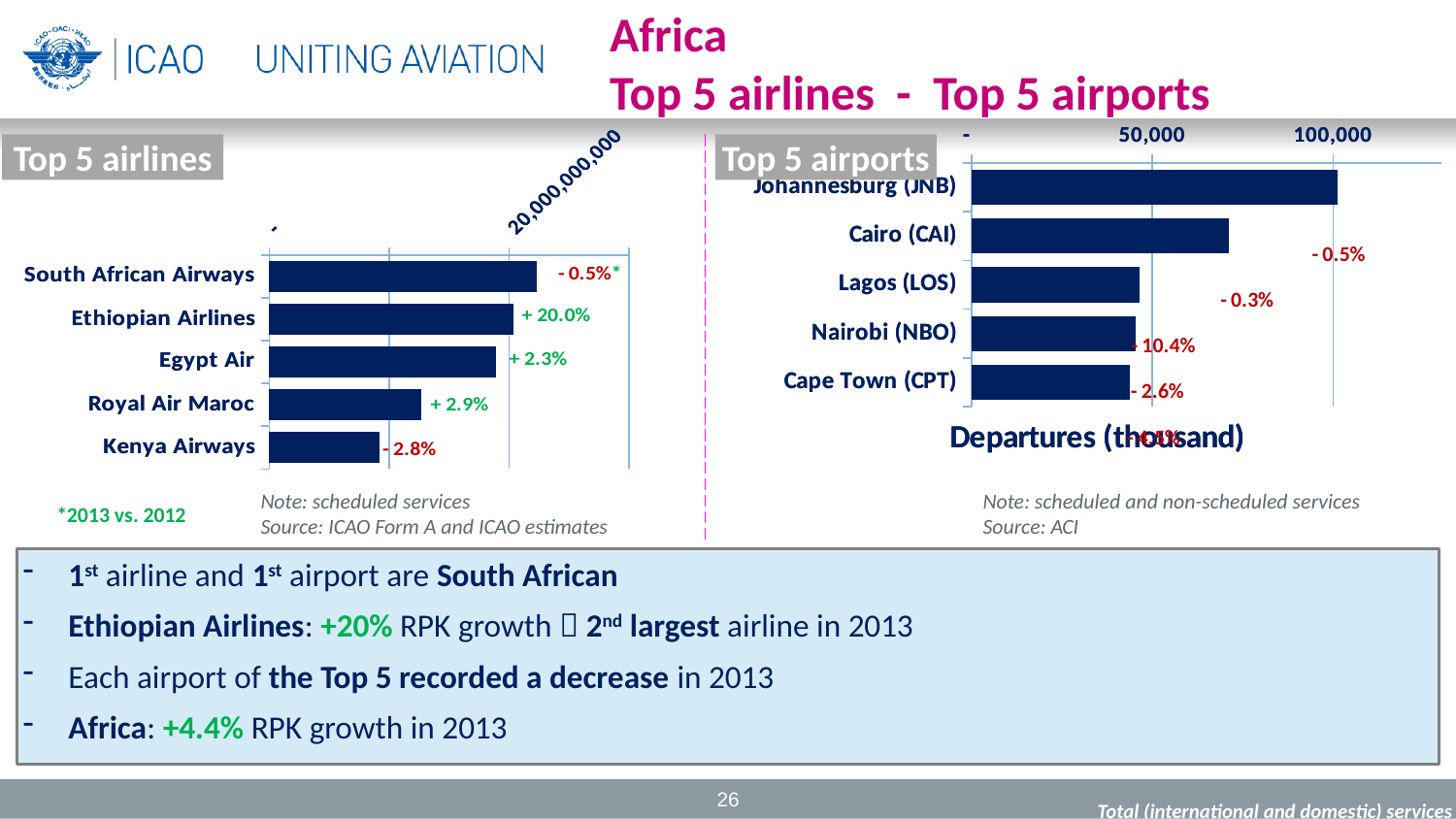
In the 'Top 5 airlines' chart, is the bar for Kenya Airways greater or less than 20,000,000,000? less In the 'Top 5 airlines' chart, what growth percentage is labelled next to Royal Air Maroc? + 2.9% In the 'Top 5 airlines' chart, which airline has the longest bar? South African Airways What is the axis label shown below the 'Top 5 airports' chart? Departures (thousand) How many airlines are shown in the 'Top 5 airlines' chart? 5 In the 'Top 5 airlines' chart, what growth percentage is labelled next to Ethiopian Airlines? + 20.0% In the 'Top 5 airlines' chart, which airline has the shortest bar? Kenya Airways In the 'Top 5 airports' chart, is the value for Cairo (CAI) greater or less than 50,000? greater In the 'Top 5 airlines' chart, what growth percentage is labelled next to Kenya Airways? - 2.8% In the 'Top 5 airports' chart, which airport has the longest bar? Johannesburg (JNB) In the 'Top 5 airports' chart, which has the larger bar, Johannesburg (JNB) or Cairo (CAI)? Johannesburg (JNB) What kind of chart is the 'Top 5 airlines' chart? Bar chart